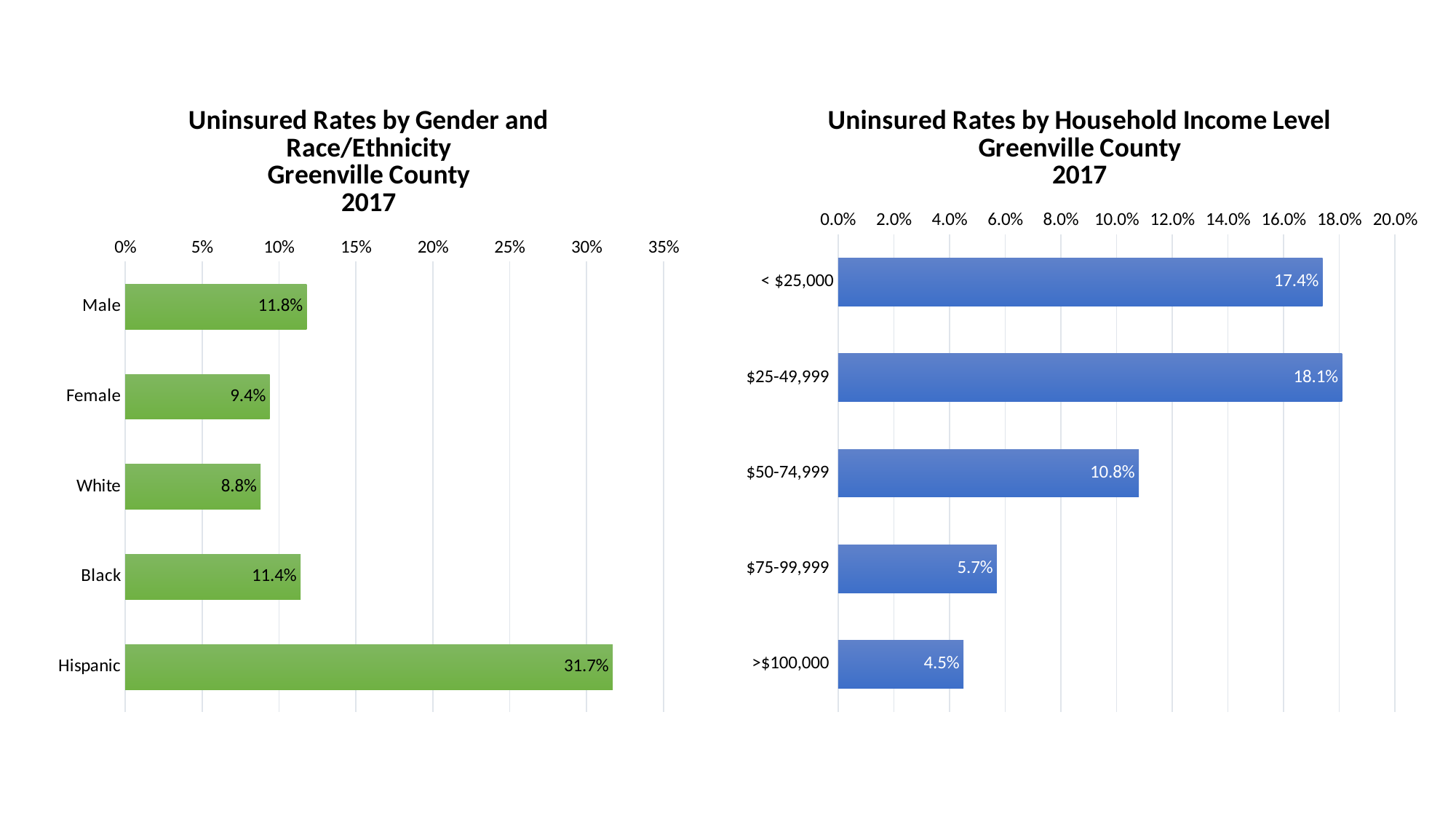
In the 'Uninsured Rates by Gender and Race/Ethnicity' chart, what is the uninsured rate for Female? 9.4% In the 'Uninsured Rates by Household Income Level' chart, which income level has the highest uninsured rate? $25-49,999 What type of chart is the 'Uninsured Rates by Household Income Level' chart? Bar chart In the 'Uninsured Rates by Household Income Level' chart, what is the uninsured rate for >$100,000? 4.5% In the 'Uninsured Rates by Gender and Race/Ethnicity' chart, which category has the highest uninsured rate? Hispanic In the 'Uninsured Rates by Household Income Level' chart, which is larger, the uninsured rate for $75-99,999 or for >$100,000? $75-99,999 In the 'Uninsured Rates by Household Income Level' chart, what is the uninsured rate for $50-74,999? 10.8% In the 'Uninsured Rates by Gender and Race/Ethnicity' chart, which category has the lowest uninsured rate? White In the 'Uninsured Rates by Gender and Race/Ethnicity' chart, what is the difference between the Male and Female uninsured rates? 2.4% In the 'Uninsured Rates by Household Income Level' chart, what is the difference between the uninsured rates for < $25,000 and $50-74,999? 6.6% In the 'Uninsured Rates by Gender and Race/Ethnicity' chart, what is the uninsured rate for Hispanic? 31.7% In the 'Uninsured Rates by Gender and Race/Ethnicity' chart, how many categories are shown? 5